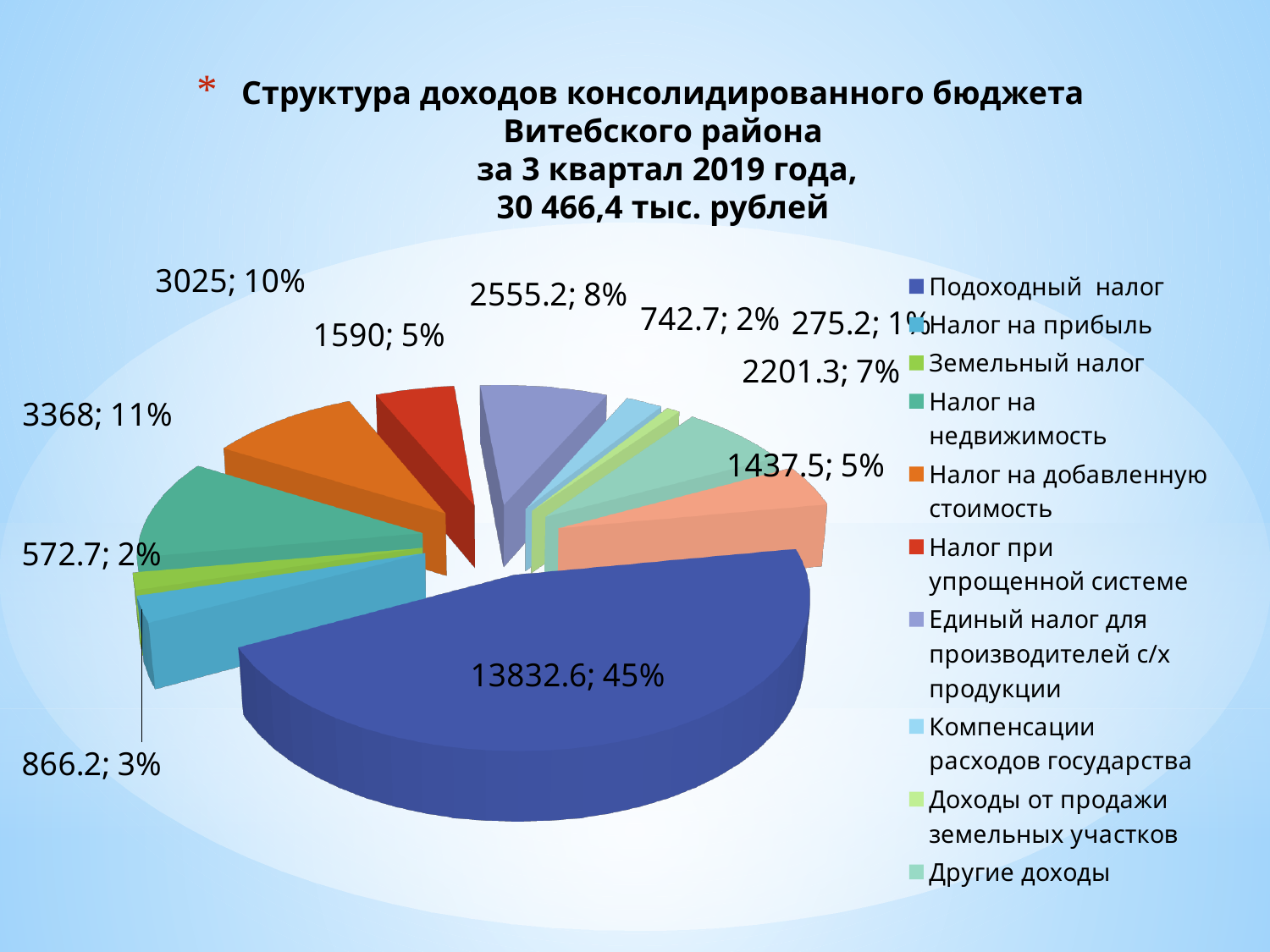
What is the difference between the values for Подоходный налог and Налог на прибыль? 12966.4 What share of the pie does Другие доходы take? 7% What colour is the slice for Подоходный налог? Dark blue What total amount is stated in the chart title? 30 466,4 тыс. рублей What value is shown for Налог на прибыль? 866.2 Which is larger, the value for Земельный налог or the value for Компенсации расходов государства? Компенсации расходов государства What share of the pie does Подоходный налог take? 45% What kind of chart is shown on the slide? Pie chart What value is shown for Единый налог для производителей с/х продукции? 2555.2 What value is shown for Подоходный налог? 13832.6 Which category has the largest slice of the pie? Подоходный налог How many slices does the pie chart have? 11